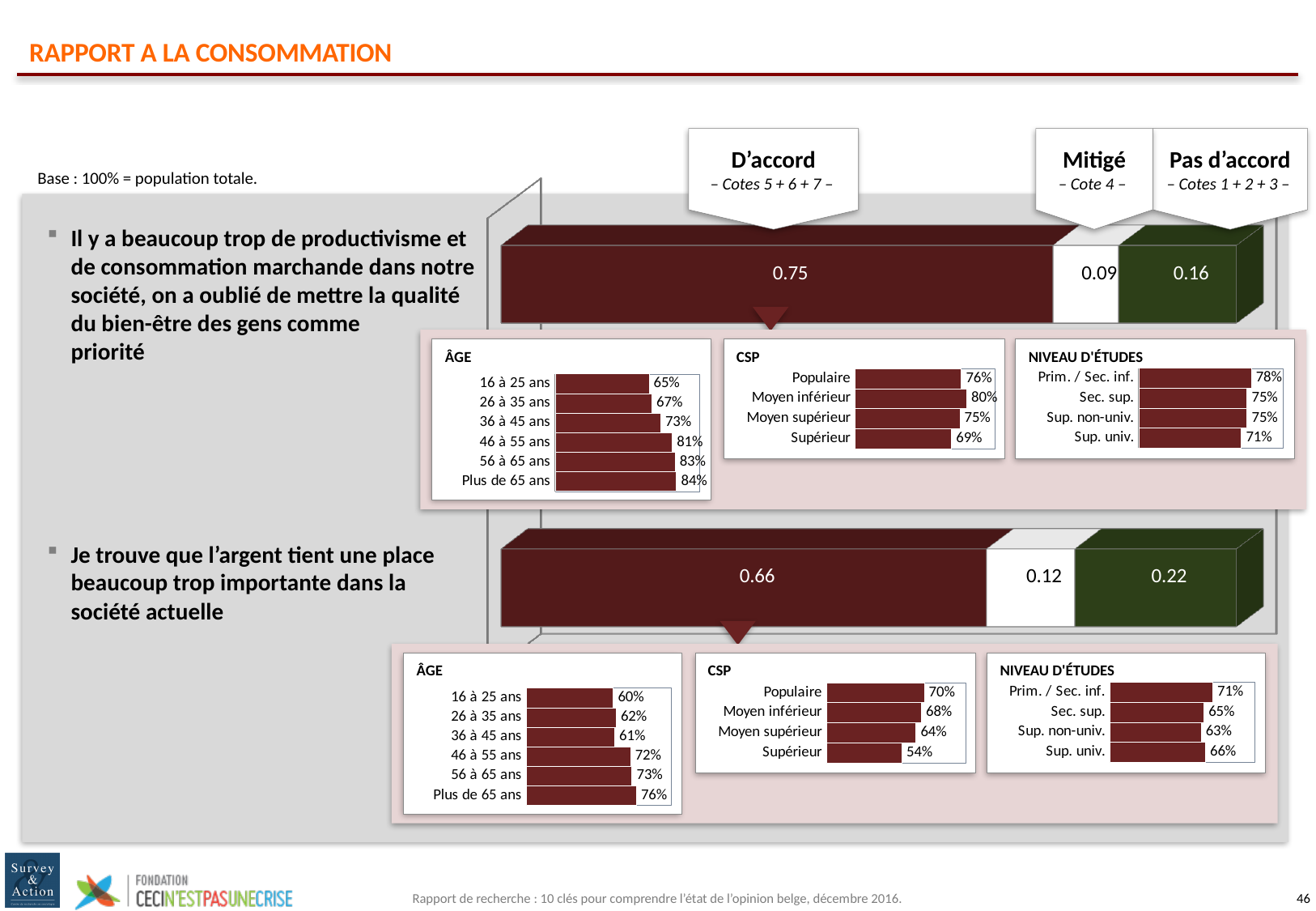
In the stacked bar for the statement "Je trouve que l'argent tient une place beaucoup trop importante...", what is the value for "Mitigé"? 0.12 In the upper NIVEAU D'ÉTUDES chart (productivisme statement), what is the value for "Prim. / Sec. inf."? 78% In the upper ÂGE chart (productivisme statement), which age group has the highest value? Plus de 65 ans In the lower CSP chart (argent statement), what is the value for "Supérieur"? 54% In the lower ÂGE chart (argent statement), which is larger: "26 à 35 ans" or "46 à 55 ans"? 46 à 55 ans In the stacked bar for the statement "Je trouve que l'argent tient une place beaucoup trop importante...", what is the value for "Pas d'accord"? 0.22 In the lower ÂGE chart (argent statement), how many age categories are shown? 6 In the upper ÂGE chart (productivisme statement), what is the value for "46 à 55 ans"? 81% In the upper CSP chart (productivisme statement), what is the difference between "Moyen inférieur" and "Supérieur"? 11% In the stacked bar for the statement "Il y a beaucoup trop de productivisme et de consommation marchande...", what is the value for "D'accord"? 0.75 In the upper CSP chart (productivisme statement), which category has the lowest value? Supérieur In the lower NIVEAU D'ÉTUDES chart (argent statement), which category has the highest value? Prim. / Sec. inf.